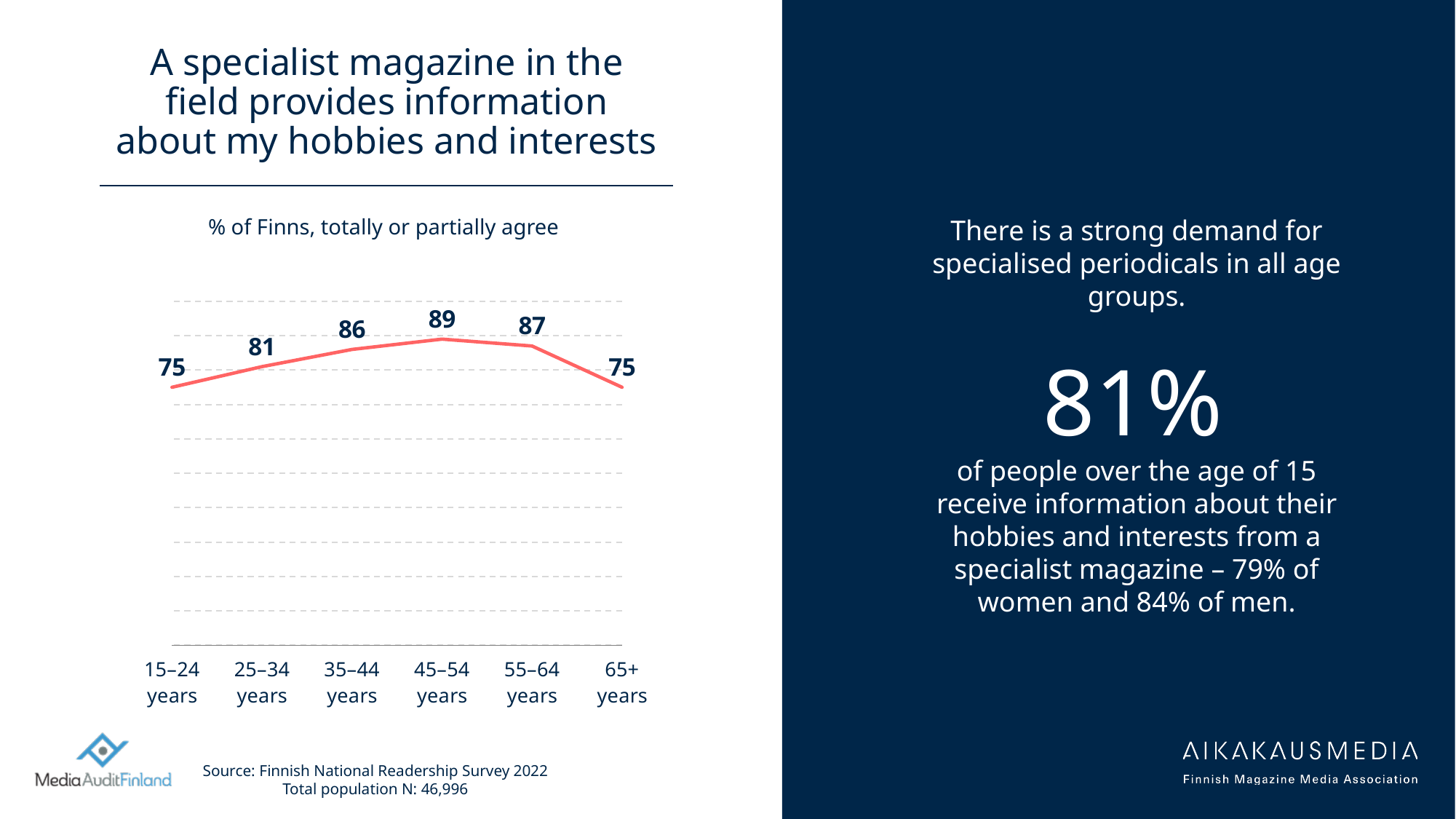
How many age groups are plotted on the chart? 6 What is the value for the 55–64 years age group? 87 Which age group has the highest value? 45–54 years What kind of chart is shown on the slide? Line chart What is the difference between the values for 35–44 years and 25–34 years? 5 What does the subtitle above the chart say the values represent? % of Finns, totally or partially agree What is the value for the 45–54 years age group? 89 What is the difference between the values for 45–54 years and 15–24 years? 14 Which is larger, the value for 35–44 years or the value for 55–64 years? 55–64 years Do the values rise or fall from 15–24 years to 45–54 years? Rise What is the value for the 25–34 years age group? 81 Do the values rise or fall from 45–54 years to 65+ years? Fall